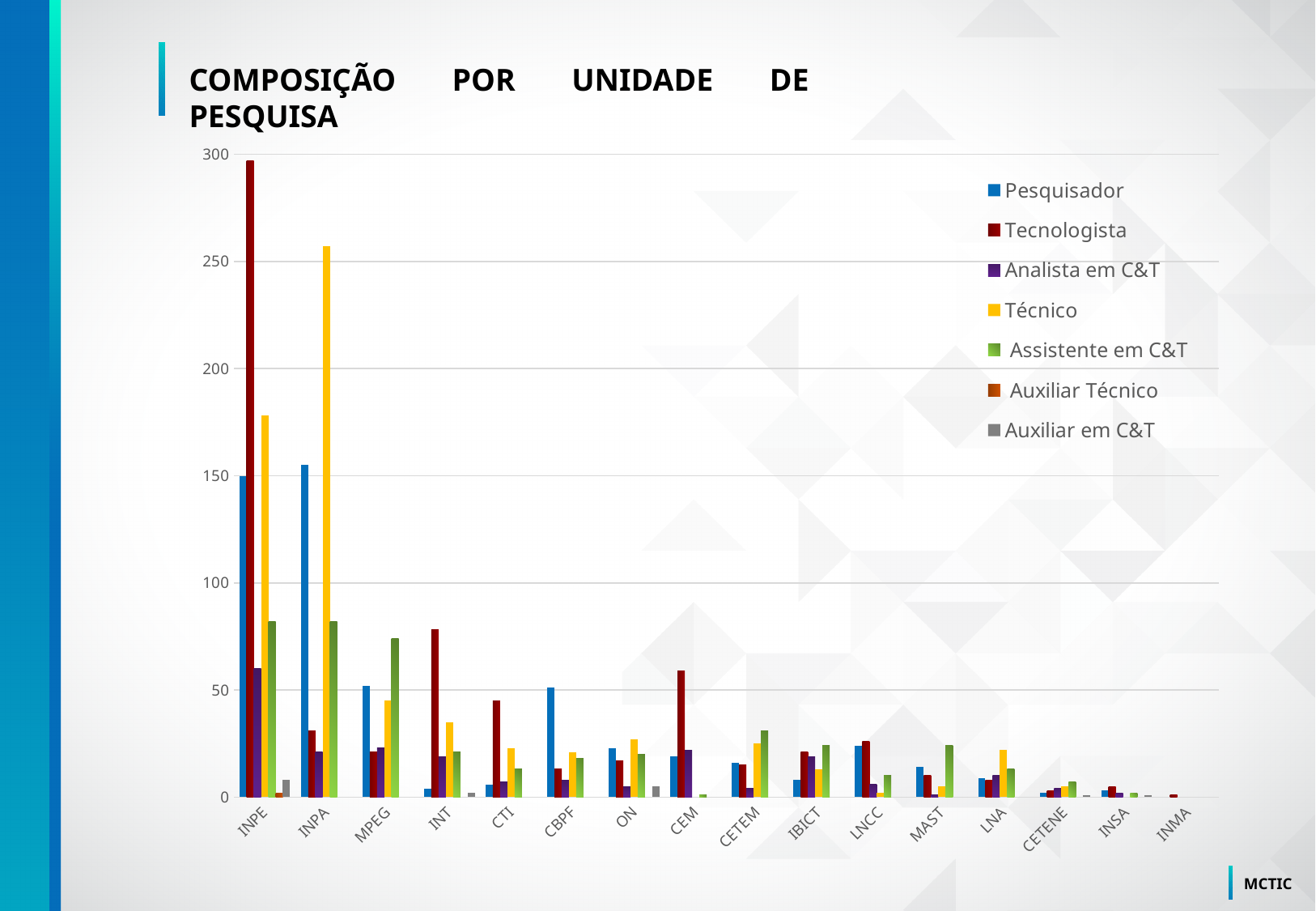
Is the Assistente em C&T value for INPE greater or less than 100? less How many series does the legend list? 7 Is the Tecnologista value for INT greater or less than 50? greater What kind of chart is shown on the slide? bar chart Which research unit has the highest Tecnologista value? INPE Is the Pesquisador value for INPA greater or less than 100? greater Which is larger: the Tecnologista value for INPE or the Técnico value for INPA? Tecnologista value for INPE Which research unit has the highest Técnico value? INPA What is the title of the chart on the slide? COMPOSIÇÃO POR UNIDADE DE PESQUISA How many research units (categories) are shown on the x axis? 16